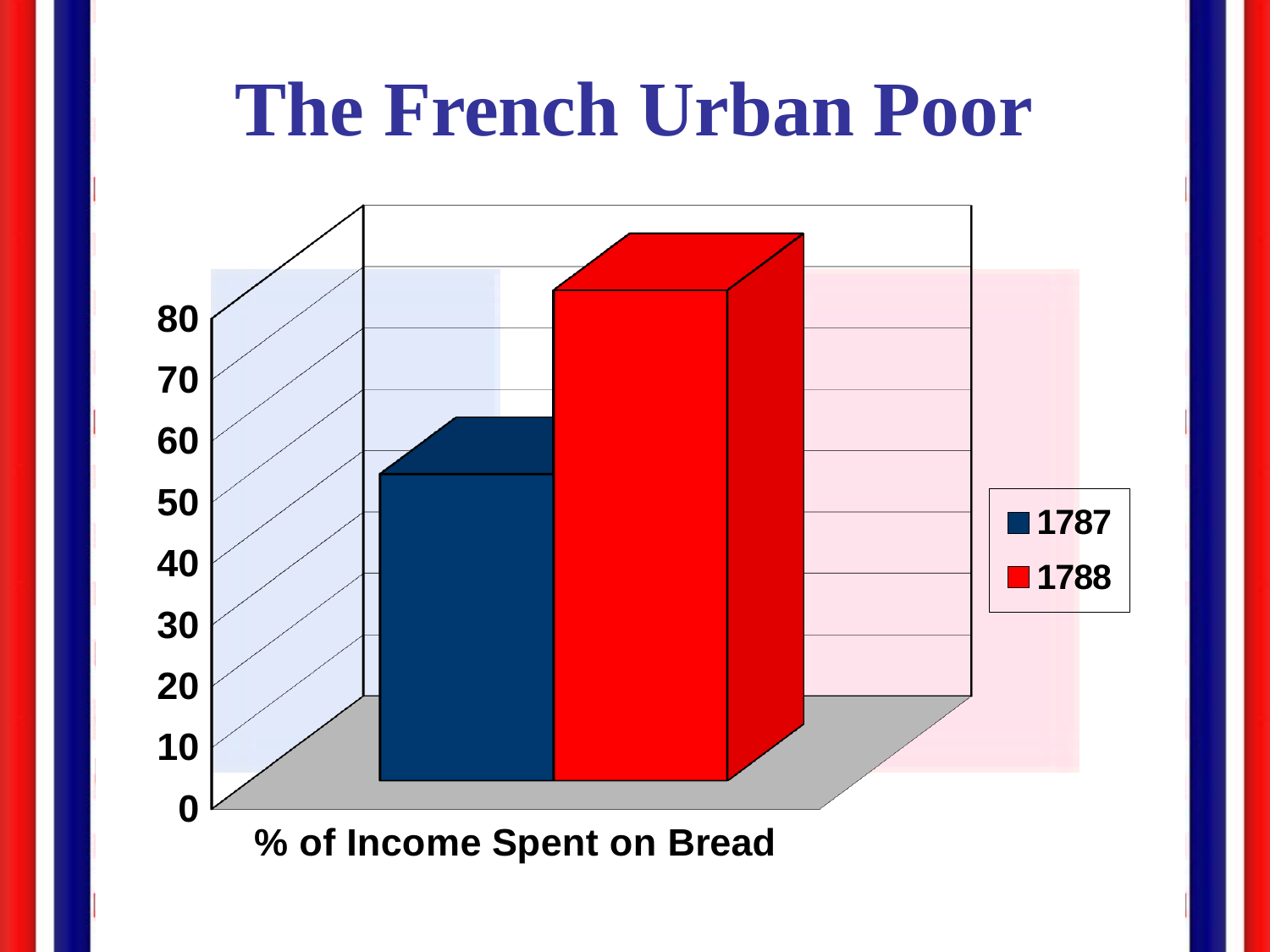
Is the value for 1787 greater or less than 60? less Which series has the lower value for % of Income Spent on Bread? 1787 How many series does the legend list? 2 Is the value for 1788 larger or smaller than the value for 1787? larger What colour represents the 1788 series in the legend? red Is the value for 1787 greater or less than 40? greater What is the title of the slide containing the chart? The French Urban Poor How many categories are shown on the x axis? 1 Which series has the higher value for % of Income Spent on Bread? 1788 Is the value for 1788 greater or less than 70? greater What kind of chart is shown on the slide? bar chart